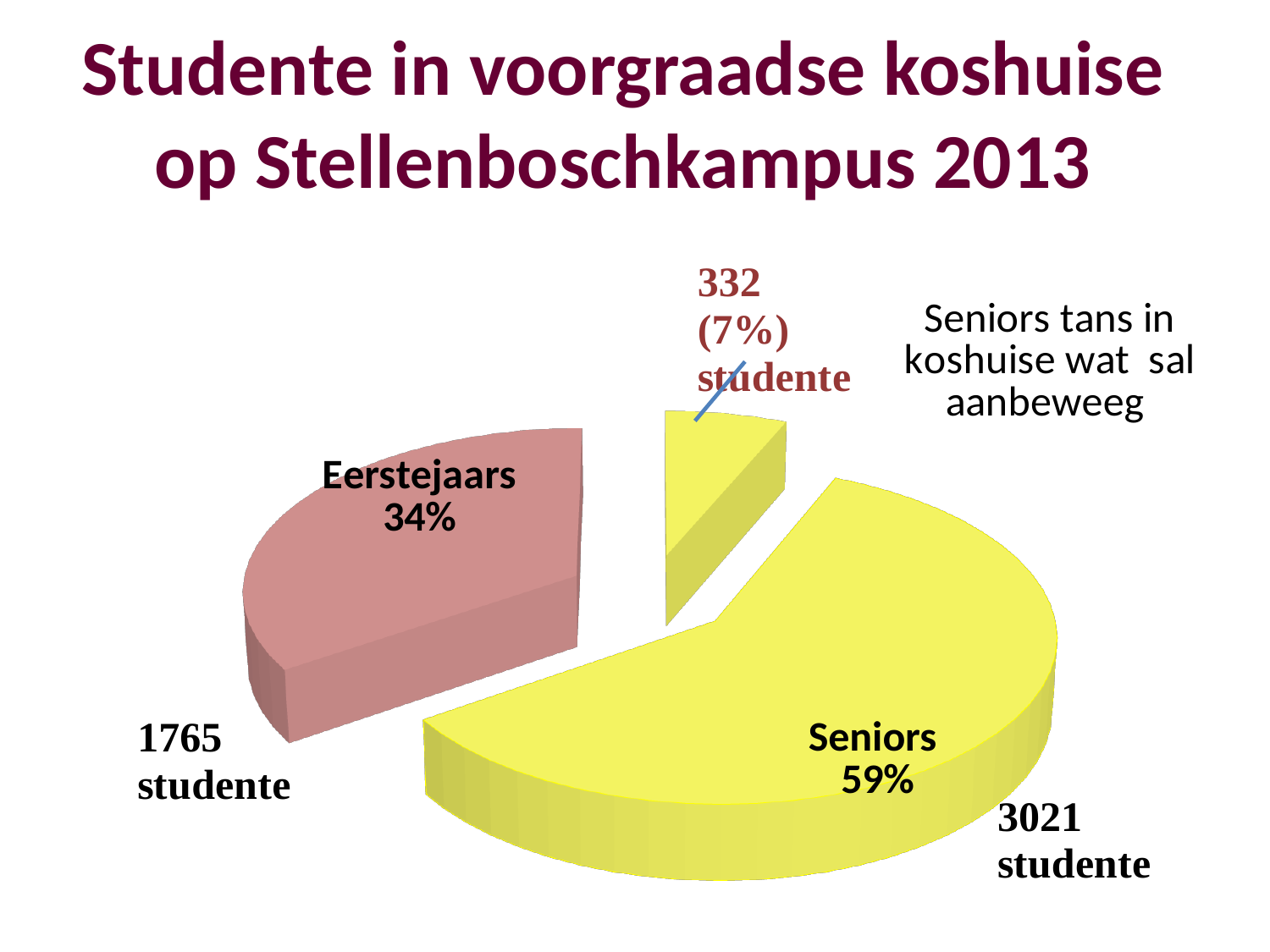
What is the title of the chart on the slide? Studente in voorgraadse koshuise op Stellenboschkampus 2013 What is the difference in number of students between the Seniors slice and the Eerstejaars slice? 1256 How many students are in the Eerstejaars slice? 1765 studente What percentage share of the pie is the slice for seniors currently in residences who will move out (Seniors tans in koshuise wat sal aanbeweeg)? 7% Which slice of the pie chart is the largest? Seniors Which slice of the pie chart is the smallest? Seniors tans in koshuise wat sal aanbeweeg (332 studente) What kind of chart is shown on the slide? pie chart How many students are in the Seniors slice? 3021 studente What percentage share of the pie is the Eerstejaars slice? 34% What percentage share of the pie is the Seniors slice? 59% How many students are in the slice for seniors who will move out of residences? 332 studente How many slices does the pie chart have? 3